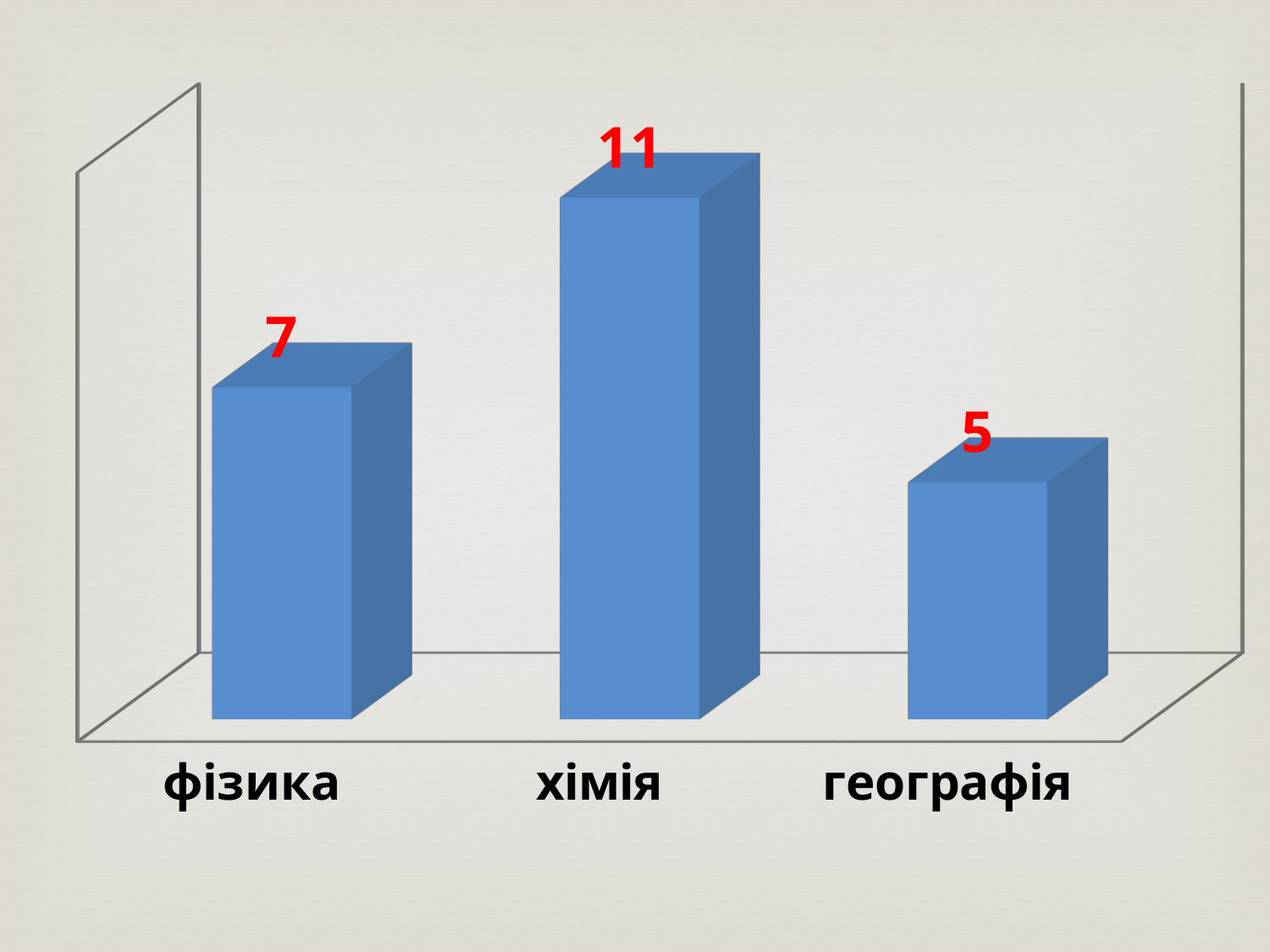
What kind of chart is shown on the slide? bar chart What is the value for фізика? 7 Which category has the highest value? хімія How many categories are shown on the chart? 3 What is the difference between the values for хімія and фізика? 4 What colour are the data labels on the chart? red What is the value for географія? 5 What is the difference between the values for фізика and географія? 2 What is the value for хімія? 11 Which is larger, the value for фізика or the value for географія? фізика Which category has the lowest value? географія What colour are the bars on the chart? blue